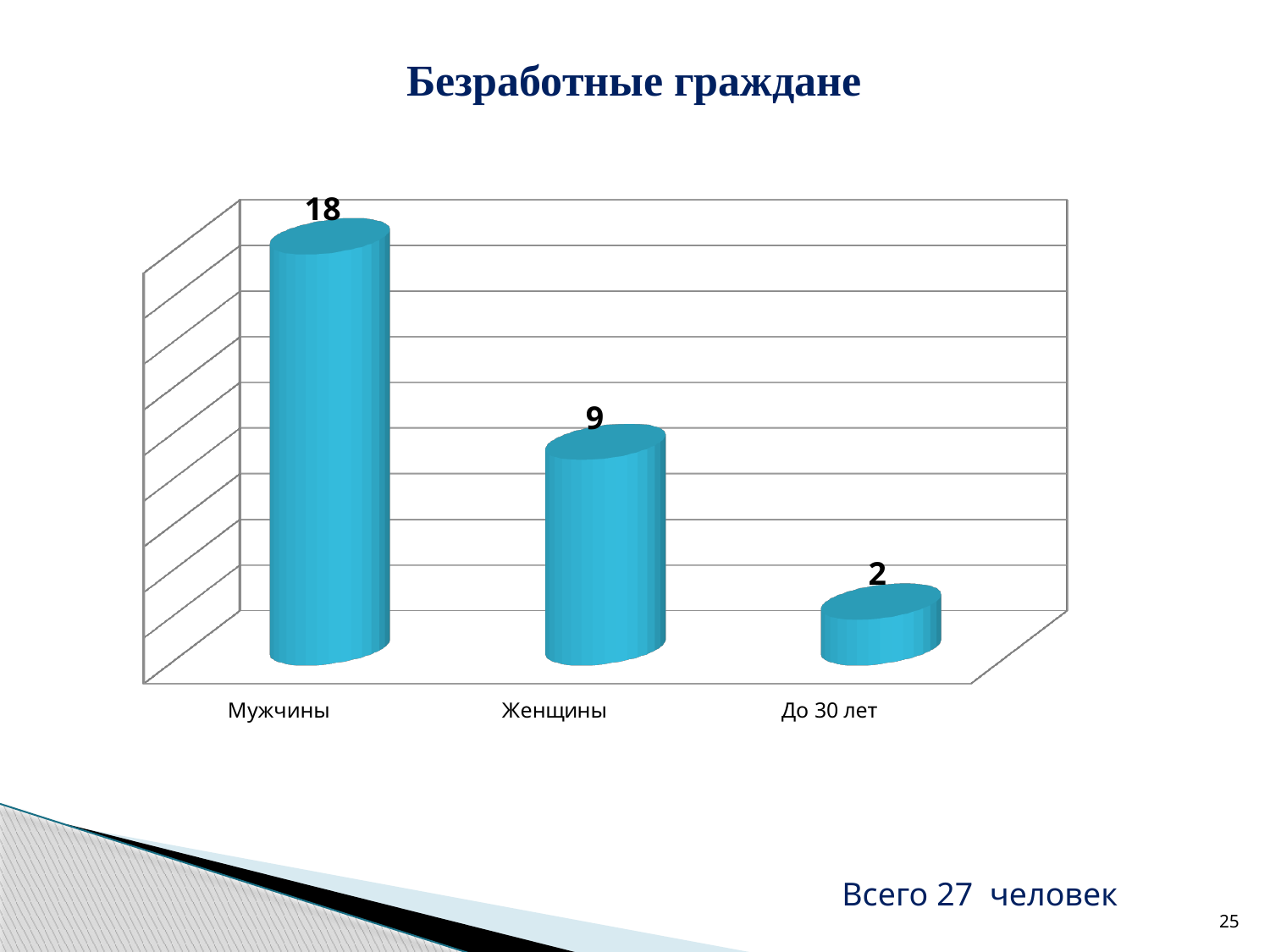
What is the value for До 30 лет? 2 What is the value for Мужчины? 18 Do the values rise or fall from left to right across the categories? fall What is the difference between the values for Мужчины and Женщины? 9 Which category has the lowest value? До 30 лет What is the title of the slide above the chart? Безработные граждане What is the difference between the values for Женщины and До 30 лет? 7 Which is larger, the value for Мужчины or the value for Женщины? Мужчины Which category has the highest value? Мужчины How many categories are shown on the chart? 3 What kind of chart is shown on the slide? bar chart What is the value for Женщины? 9